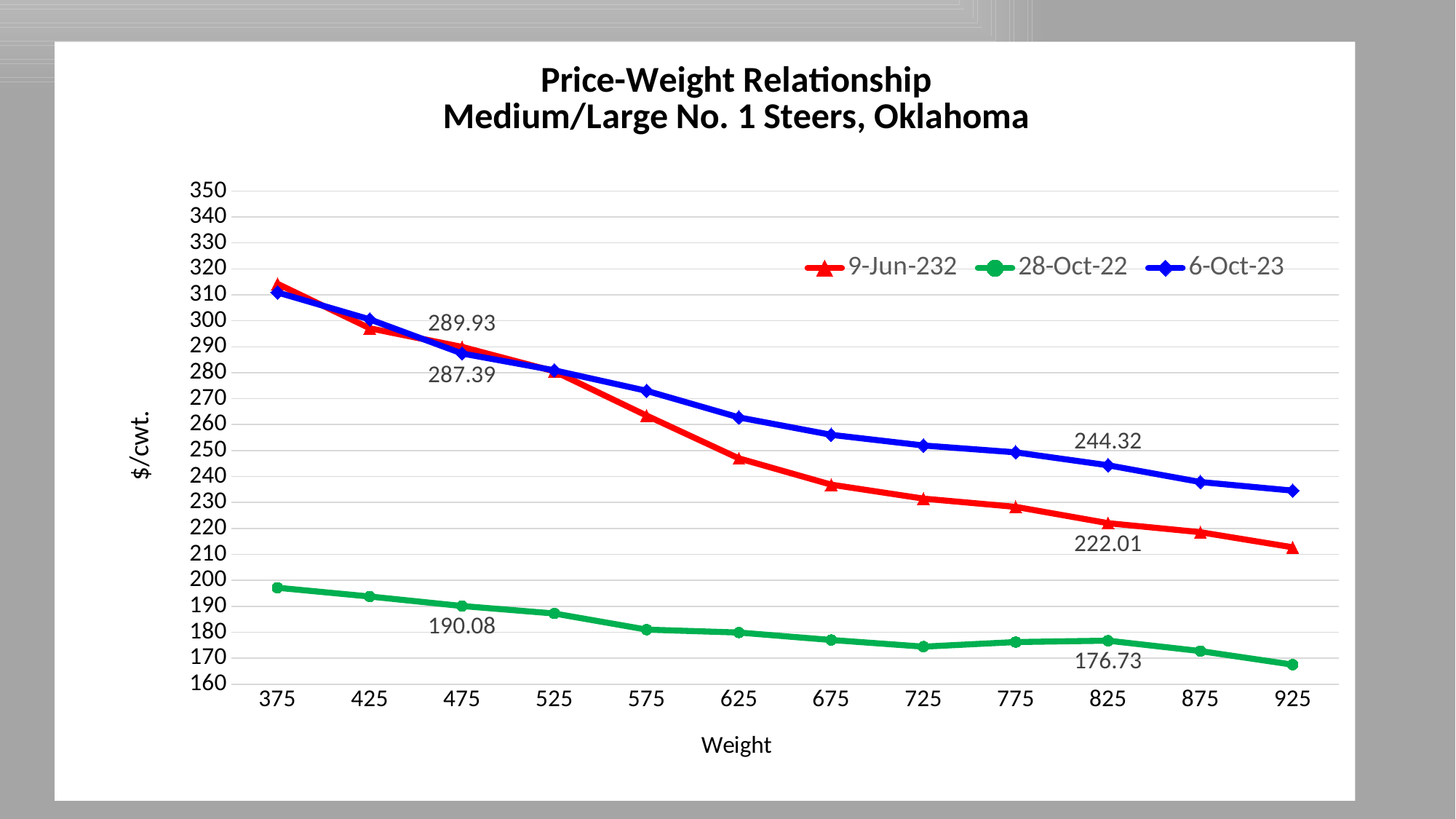
What kind of chart is shown on the slide? line chart Which series has the lowest value at a weight of 925? 28-Oct-22 What is the label on the y axis? $/cwt. Do the values of the 28-Oct-22 series generally rise or fall as weight increases? fall What is the difference between the 6-Oct-23 and 9-Jun-232 values at a weight of 825? 22.31 What is the value for the 28-Oct-22 series at a weight of 825? 176.73 What is the value for the 9-Jun-232 series at a weight of 475? 289.93 How many series does the legend list? 3 Is the value for the 9-Jun-232 series at a weight of 925 greater or less than 220? less How many weight categories are shown on the x axis? 12 What is the value for the 6-Oct-23 series at a weight of 475? 287.39 What is the value for the 6-Oct-23 series at a weight of 825? 244.32